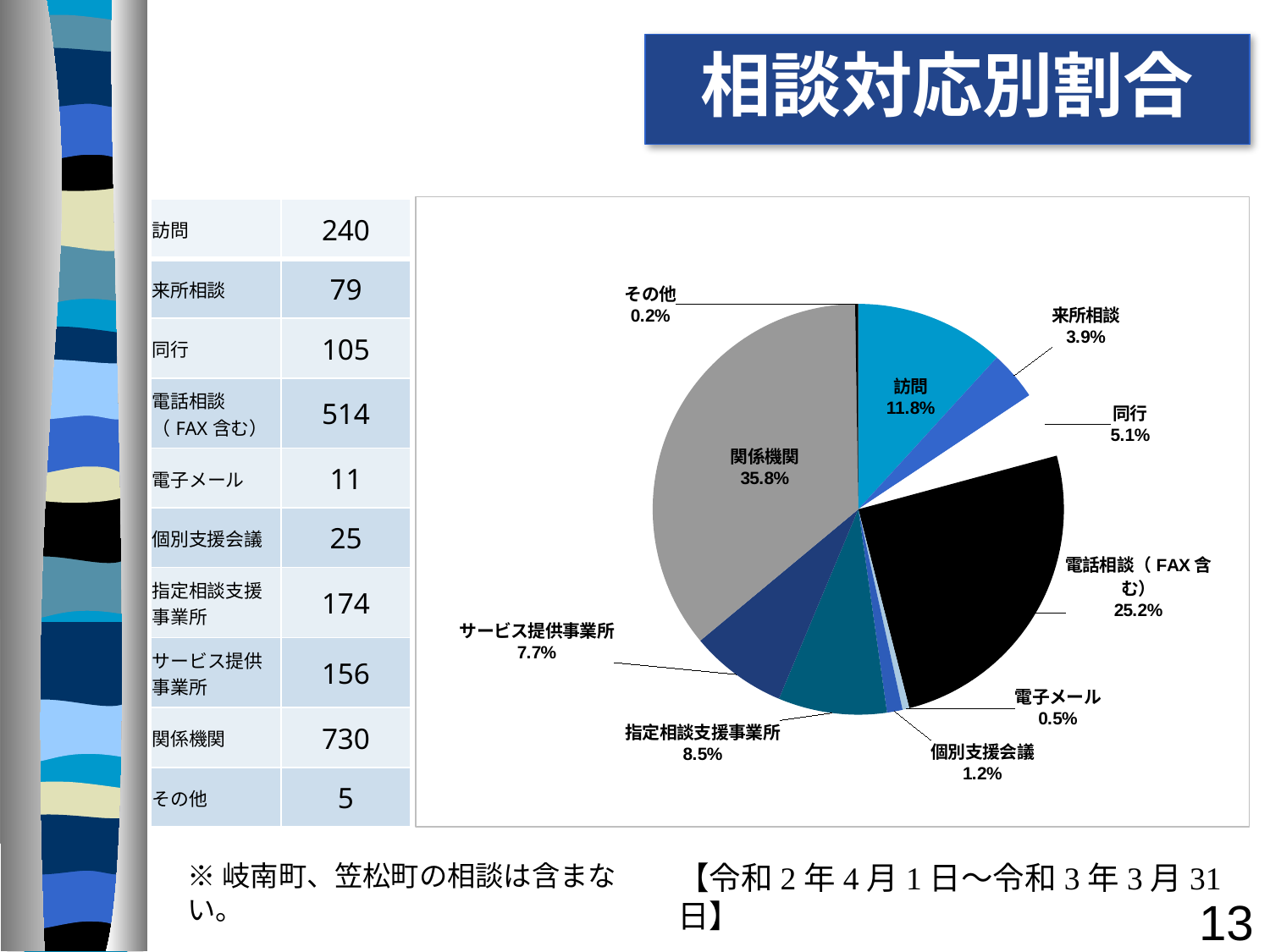
Which category has the largest slice in the pie chart? 関係機関 Which category has the smallest slice in the pie chart? その他 What percentage is shown for 訪問 in the pie chart? 11.8% What share of the pie does 関係機関 represent? 35.8% How many categories (slices) does the pie chart have? 10 What percentage is shown for 指定相談支援事業所 in the pie chart? 8.5% What is the difference in percentage points between 指定相談支援事業所 and サービス提供事業所? 0.8 What share of the pie does 電話相談（FAX含む） represent? 25.2% Which slice is larger, 同行 or 来所相談? 同行 What type of chart is shown on the slide? pie chart What is the difference in percentage points between 関係機関 and 電話相談（FAX含む）? 10.6 What is the title shown at the top of the slide? 相談対応別割合